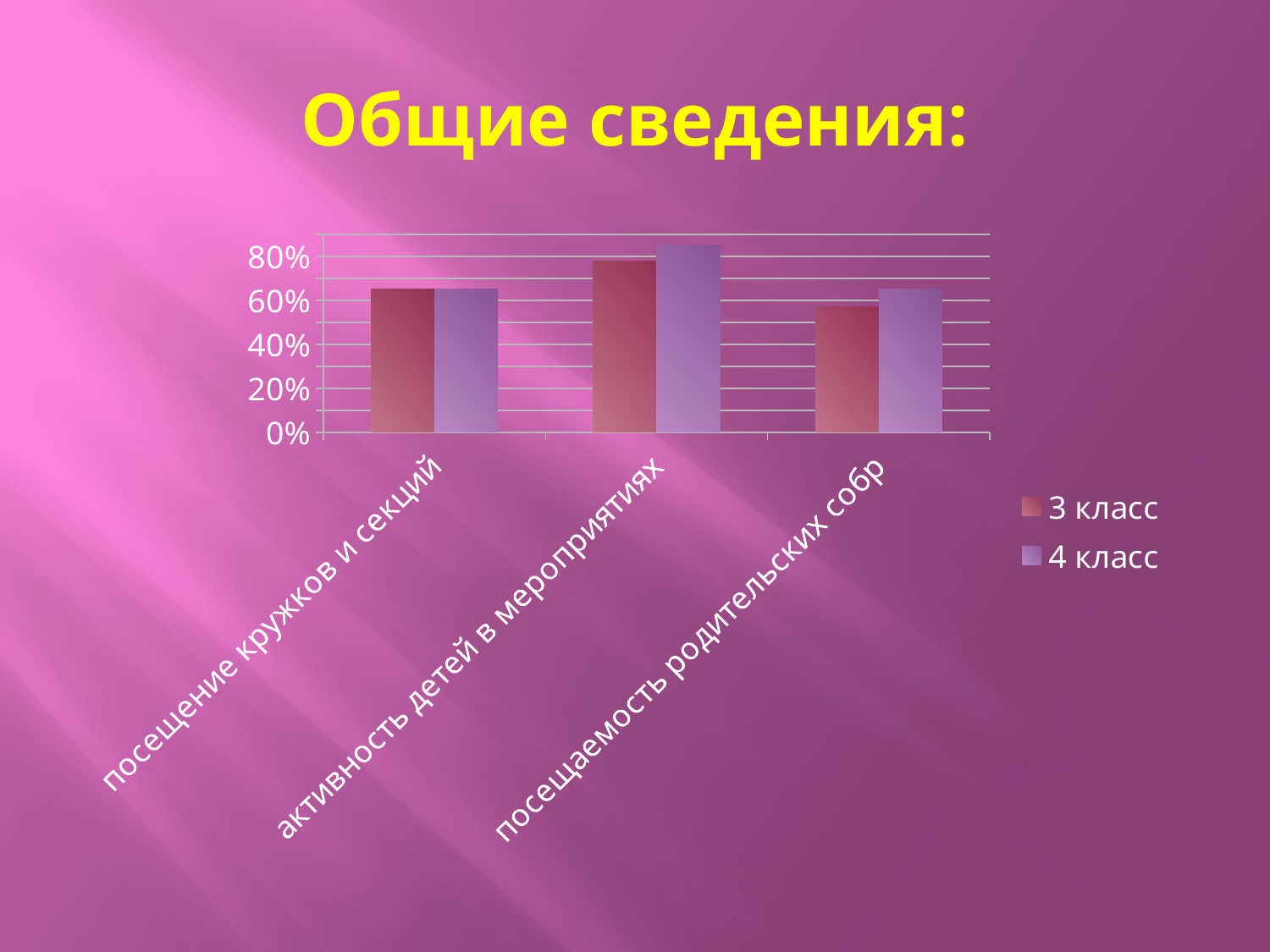
For the 3 класс series, which category has the highest value? активность детей в мероприятиях How many categories are shown on the x axis? 3 What is the title of the slide above the chart? Общие сведения: Is the value for 4 класс in "посещаемость родительских собр" greater or less than 60%? greater Is the value for 3 класс in "посещаемость родительских собр" greater or less than 60%? less Is the value for 3 класс in "активность детей в мероприятиях" greater or less than 60%? greater In "посещаемость родительских собр", which series has the larger value, 3 класс or 4 класс? 4 класс For the 3 класс series, which category has the lowest value? посещаемость родительских собр What kind of chart is shown on the slide? bar chart Which two series are listed in the legend? 3 класс and 4 класс How many series does the legend list? 2